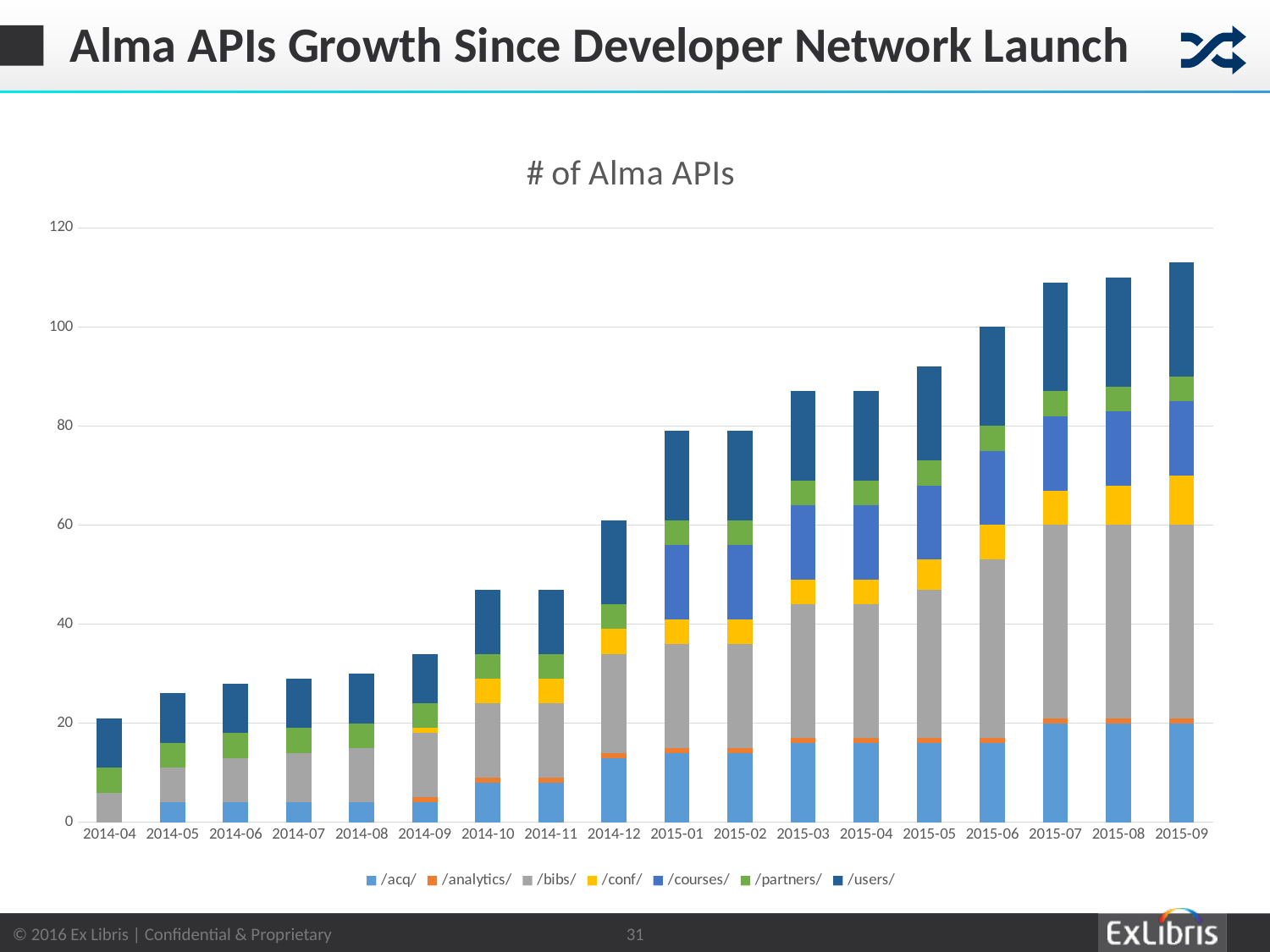
Which month has a larger total, 2014-12 or 2015-05? 2015-05 How many series does the legend list? 7 Do the total values rise or fall from 2014-04 to 2015-09? rise What kind of chart is shown on the slide? bar chart Is the total value for 2014-04 greater or less than 40? less What is the title of the chart? # of Alma APIs Which series is listed first in the legend? /acq/ How many months (categories) are shown on the x axis? 18 Which month has the lowest total number of Alma APIs? 2014-04 Is the total value for 2015-09 greater or less than 100? greater Is the total value for 2015-03 greater or less than 80? greater Which month has the highest total number of Alma APIs? 2015-09